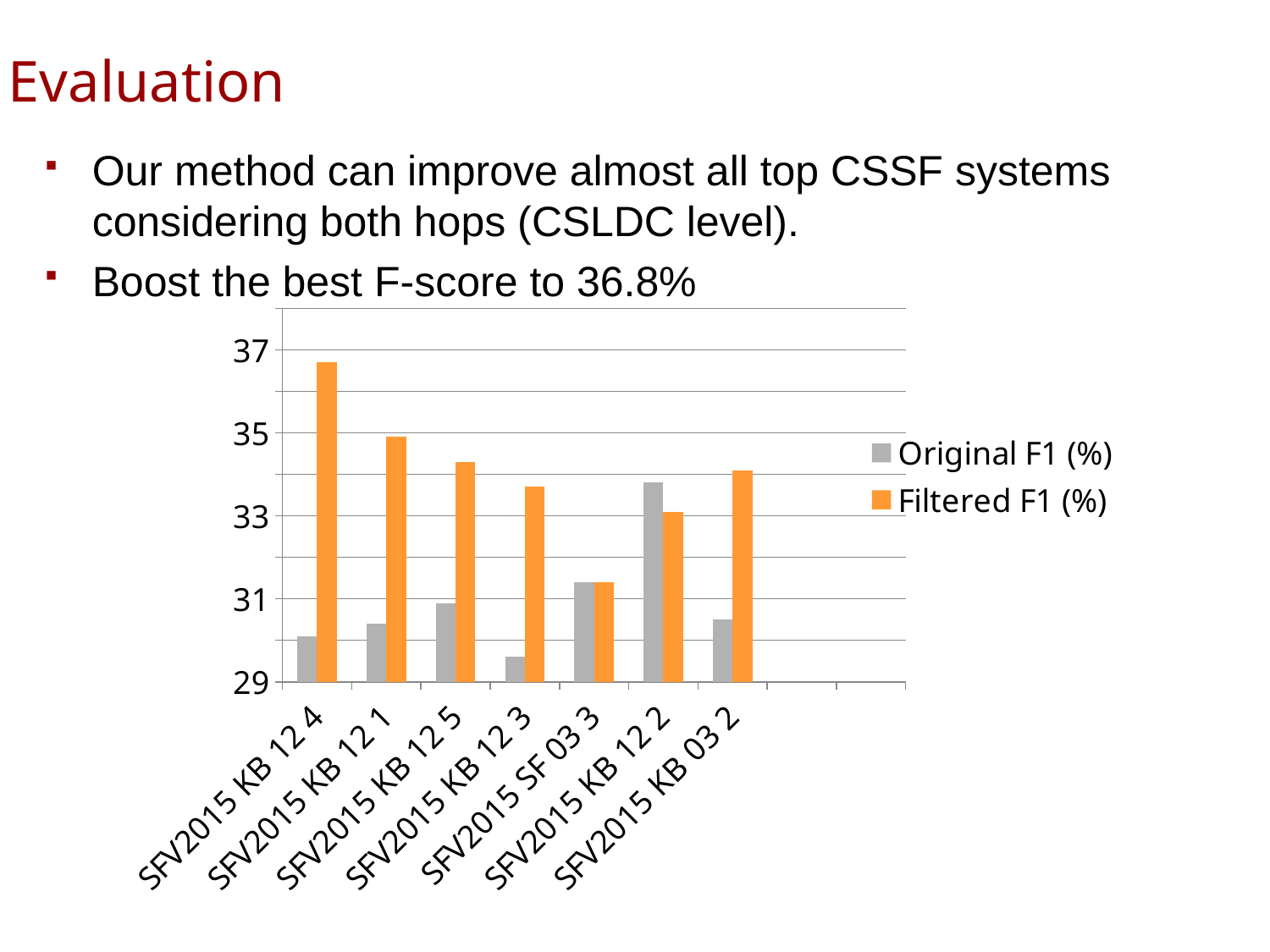
Is the Filtered F1 (%) for SFV2015 KB 12 4 greater or less than 35? greater What kind of chart is shown on the slide? bar chart For SFV2015 KB 12 2, which is larger: Original F1 (%) or Filtered F1 (%)? Original F1 (%) Is the Original F1 (%) for SFV2015 KB 12 3 greater or less than 31? less Which system has the lowest Original F1 (%) in the chart? SFV2015 KB 12 3 How many series does the chart's legend list? 2 Is the Filtered F1 (%) for SFV2015 KB 12 5 greater or less than 35? less Which system has the highest Filtered F1 (%) in the chart? SFV2015 KB 12 4 How many systems (categories) are shown on the x axis of the chart? 7 Which system has the highest Original F1 (%) in the chart? SFV2015 KB 12 2 Which system has the lowest Filtered F1 (%) in the chart? SFV2015 SF 03 3 What colour are the Filtered F1 (%) bars in the chart? orange